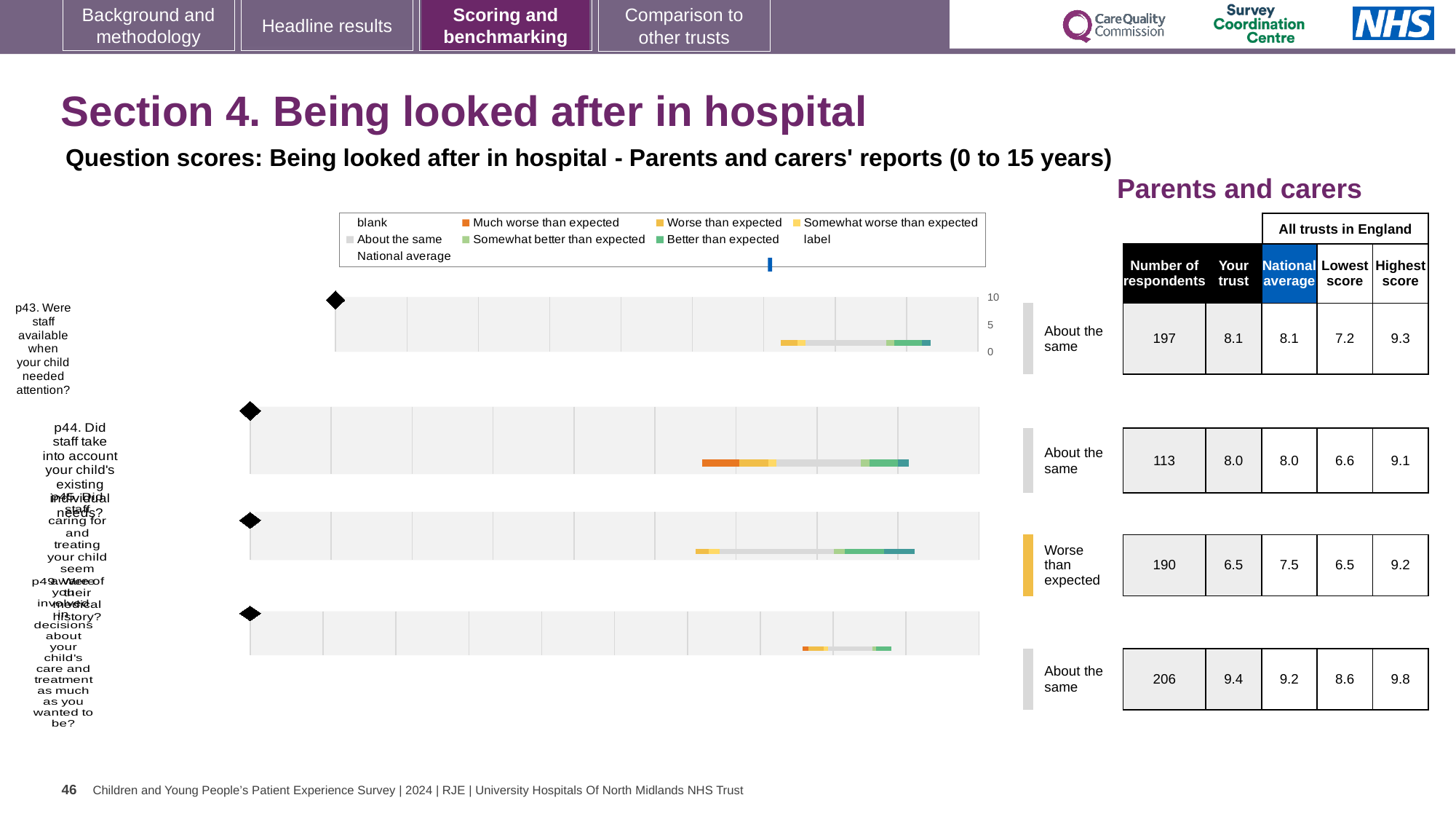
Which question row has the lowest 'Your trust' score? p45 For the third row (p45), which is larger: the 'Your trust' score or the national average? National average What is the 'Your trust' score for p43 (Were staff available when your child needed attention?)? 8.1 What is the highest score across all trusts in England for p49 (Were you involved in decisions about your child's care and treatment as much as you wanted to be?)? 9.8 For p49, what is the difference between the 'Your trust' score and the national average? 0.2 What is the number of respondents for p43 (Were staff available when your child needed attention?)? 197 How many question rows (bars) are plotted in the chart? 4 Which question row is rated 'Worse than expected'? p45 What is the national average score for p44 (Did staff take into account your child's existing individual needs?)? 8.0 What kind of chart is used to show the question scores on this slide? bar chart Which question row has the highest 'Your trust' score? p49 What is the lowest score across all trusts in England for the third row (p45)? 6.5